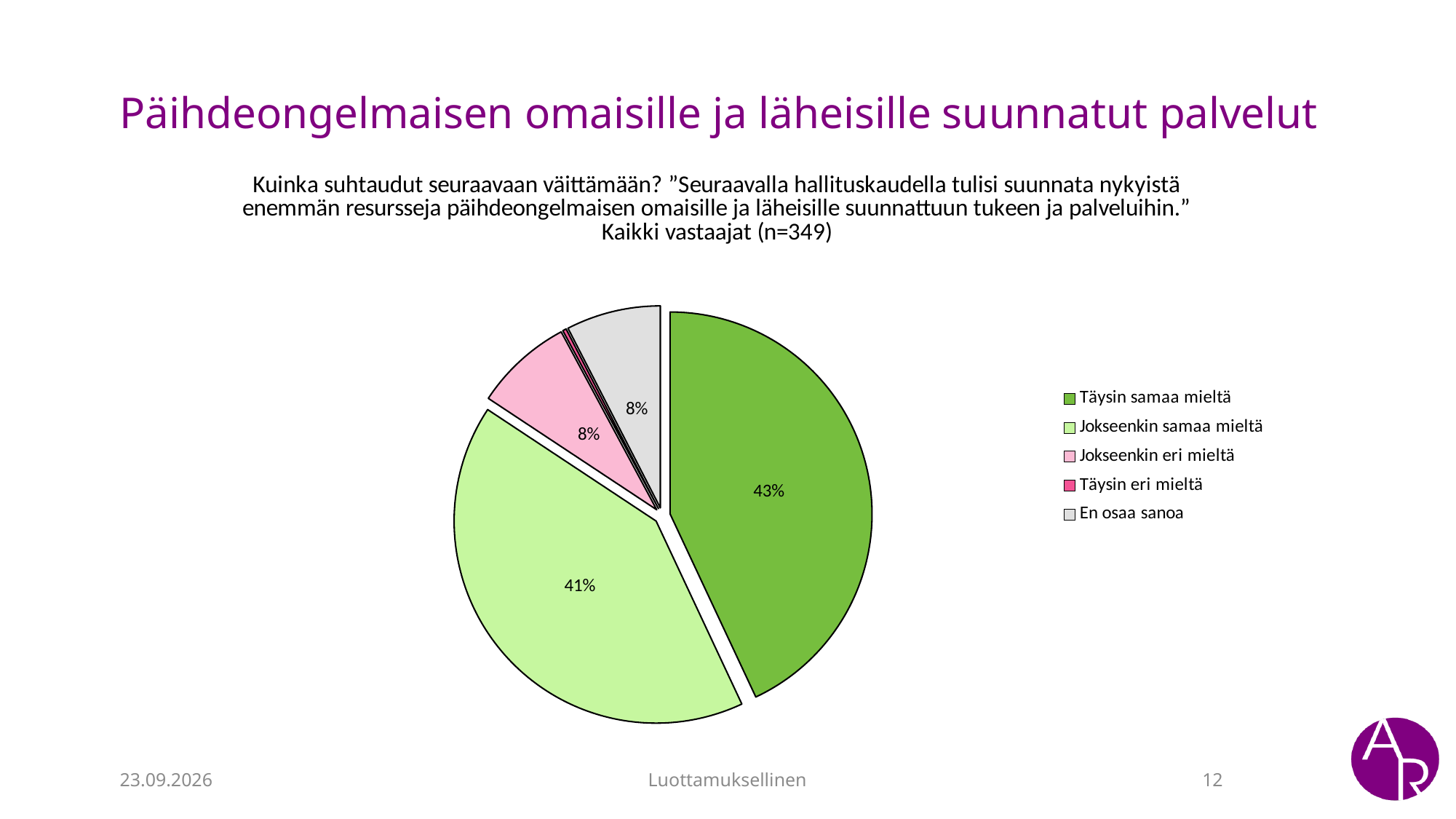
Which response category has the smallest slice of the pie? Täysin eri mieltä What is the difference in percentage points between "Täysin samaa mieltä" and "Jokseenkin samaa mieltä"? 2 percentage points What is the combined share of "Täysin samaa mieltä" and "Jokseenkin samaa mieltä"? 84% What percentage of respondents answered "Täysin samaa mieltä"? 43% What percentage is shown for "Jokseenkin eri mieltä"? 8% How many respondents (n) does the chart subtitle say were included? 349 What percentage is shown for "En osaa sanoa"? 8% Which is larger, the share for "Jokseenkin samaa mieltä" or the share for "En osaa sanoa"? Jokseenkin samaa mieltä What kind of chart is shown on the slide? Pie chart Which response category has the largest slice of the pie? Täysin samaa mieltä How many response categories does the legend list? 5 What share of the pie is "Jokseenkin samaa mieltä"? 41%